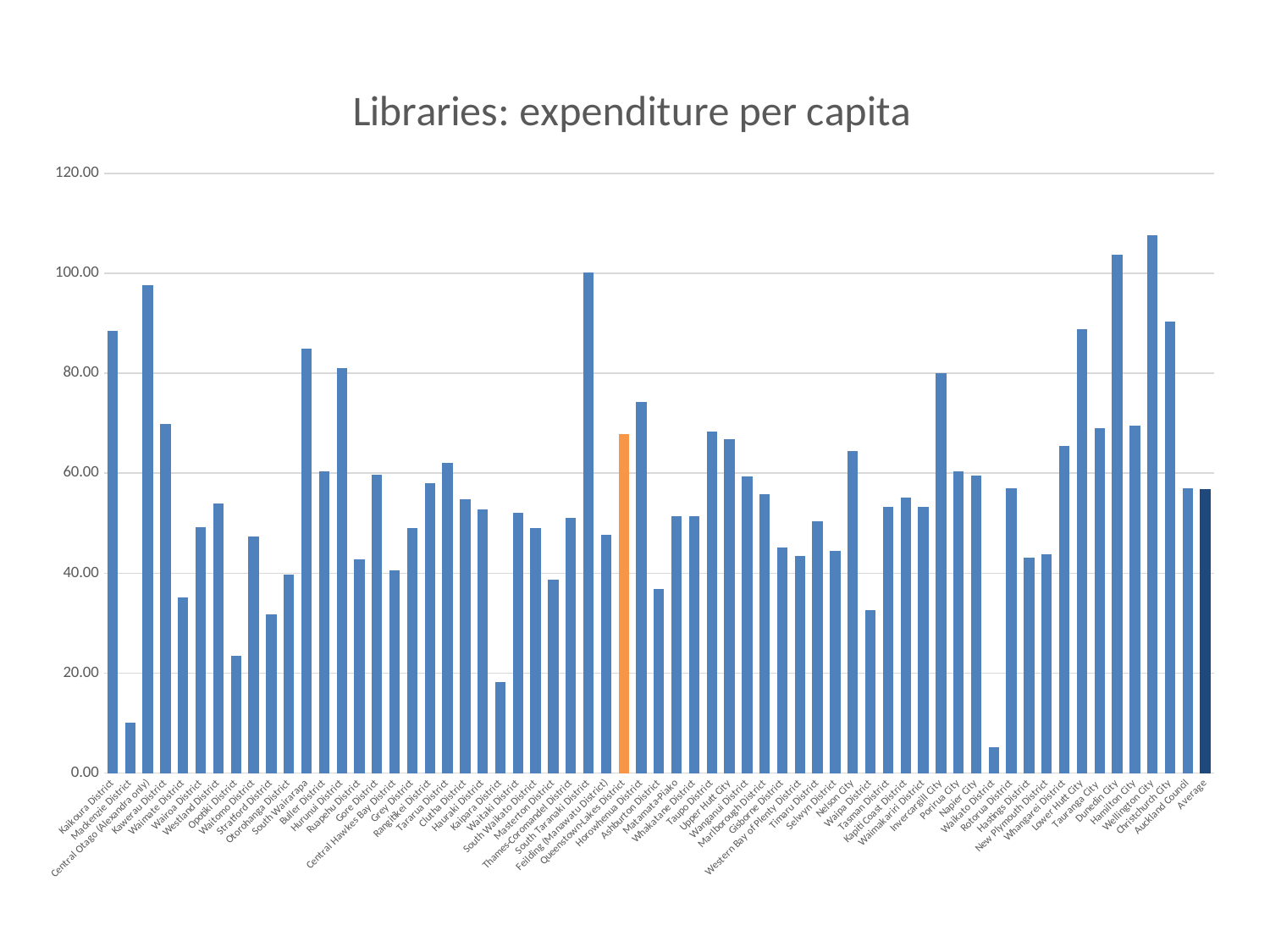
Which is larger, the value for Queenstown-Lakes District or the Average? Queenstown-Lakes District Which category has the highest expenditure per capita? Wellington City What is the title of the chart? Libraries: expenditure per capita Is the value for Kaikoura District greater or less than 80? greater Which category has the lowest expenditure per capita? Waikato District Which is larger, the value for Wellington City or the value for Auckland Council? Wellington City Is the value for Auckland Council greater or less than 80? less What kind of chart is shown on the slide? Bar chart Is the value for Queenstown-Lakes District greater or less than 60? greater Which category is highlighted with an orange bar? Queenstown-Lakes District